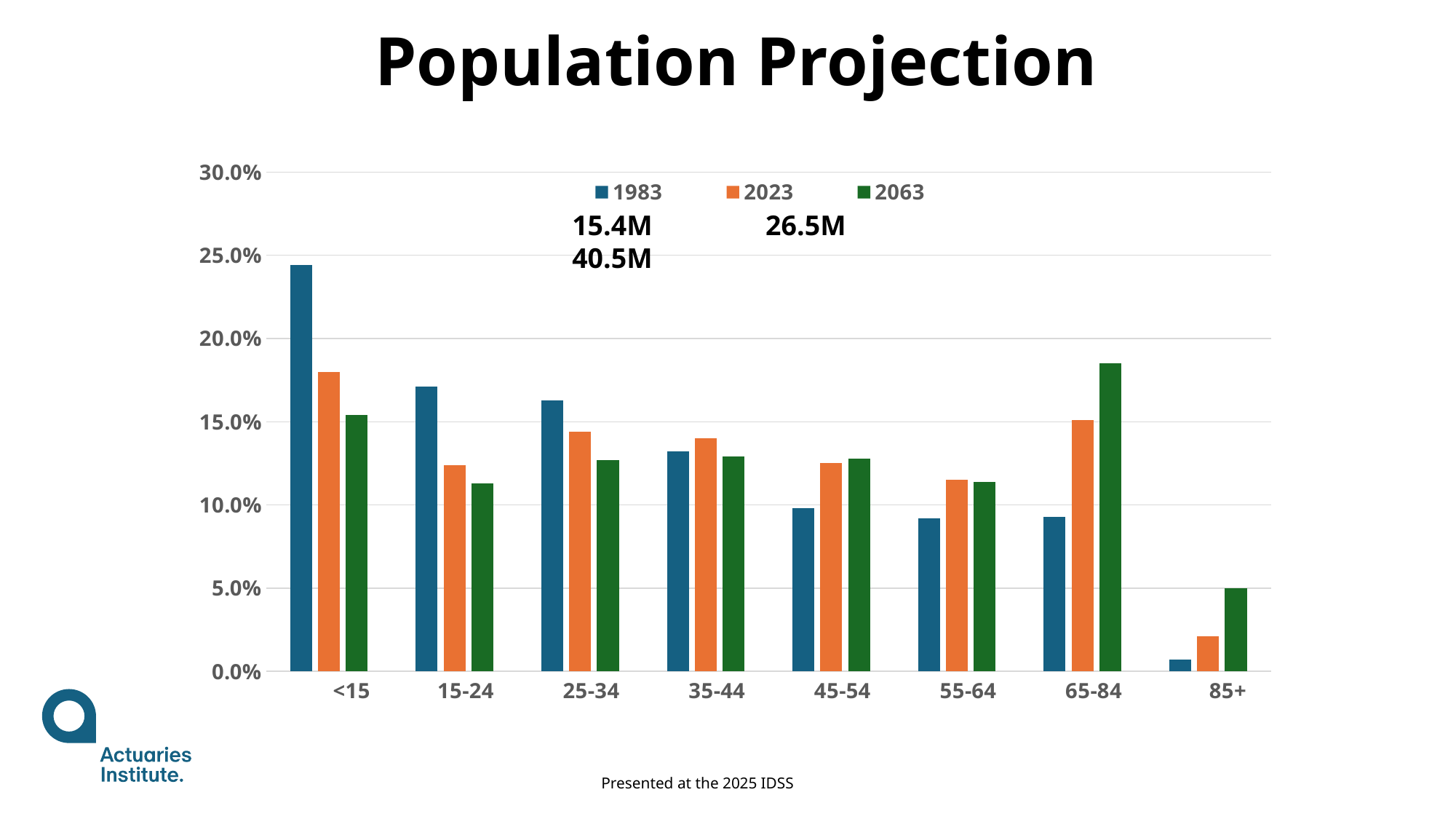
For the <15 age group, which series has the larger value, 1983 or 2063? 1983 Is the 2023 value for the 15-24 age group greater or less than 15.0%? less Which age group has the highest value for the 1983 series? <15 Which age group has the highest value for the 2063 series? 65-84 Is the 1983 value for the <15 age group greater or less than 20.0%? greater Which age group has the lowest value for the 1983 series? 85+ For the 65-84 age group, which series has the larger value, 1983 or 2063? 2063 How many series does the legend list? 3 How many age-group categories are shown on the x axis? 8 Is the 2063 value for the 65-84 age group greater or less than 15.0%? greater What kind of chart is shown on the slide? bar chart For the 85+ age group, do the values rise or fall going from 1983 to 2023 to 2063? rise